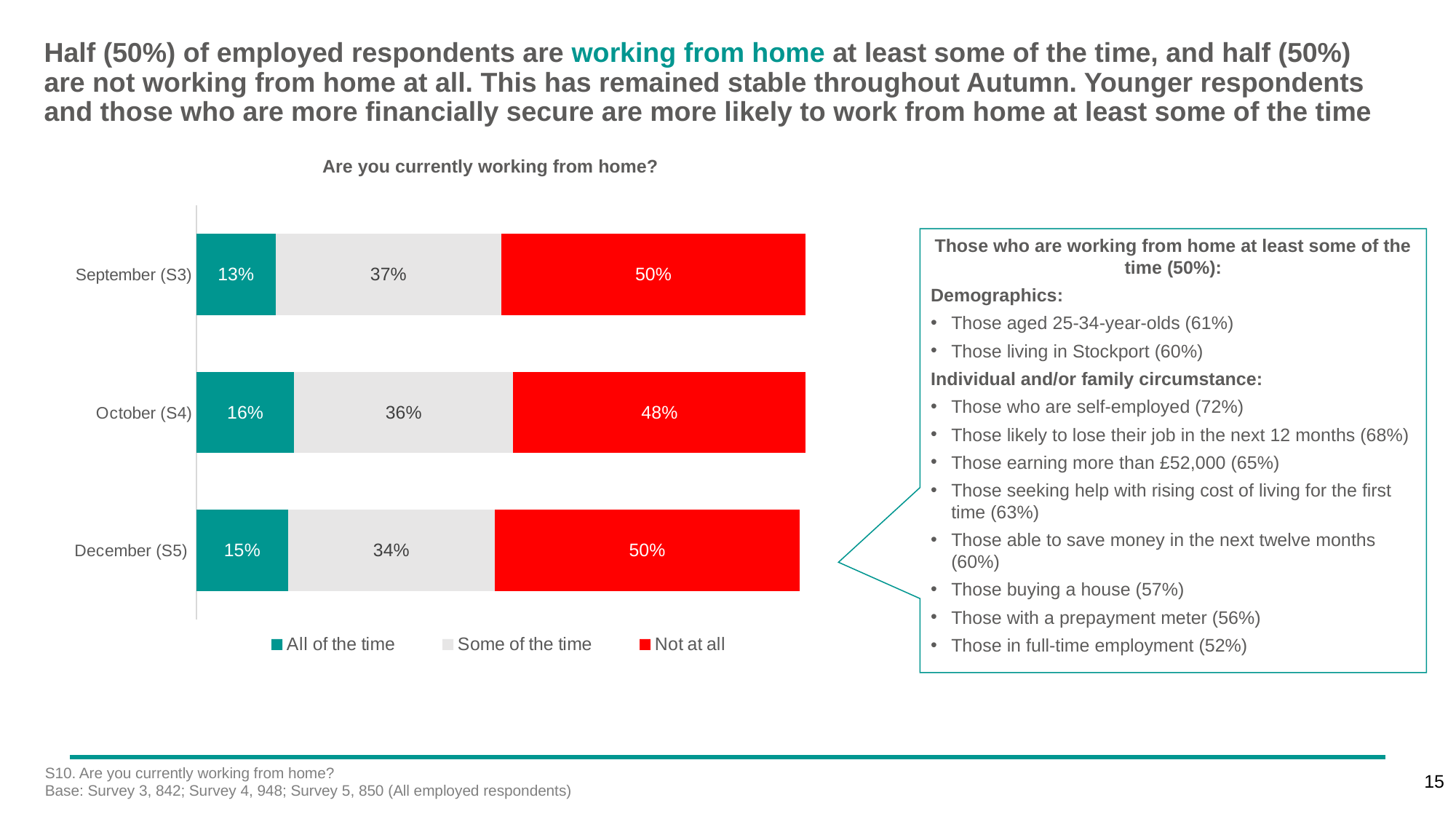
What percentage of respondents in October (S4) were not working from home at all? 48% How many series does the legend list? 3 What is the difference in percentage points between the 'Not at all' share in September (S3) and October (S4)? 2 How many survey waves (categories) are shown in the chart? 3 What percentage of respondents in December (S5) were working from home some of the time? 34% What percentage of respondents in September (S3) were working from home all of the time? 13% What is the combined percentage of respondents working from home all of the time or some of the time in October (S4)? 52% Which survey wave has the lowest share of respondents working from home some of the time? December (S5) Is the 'Some of the time' share larger in September (S3) or December (S5)? September (S3) Which survey wave has the highest share of respondents working from home all of the time? October (S4) What is the title of the chart? Are you currently working from home? What kind of chart is used to show the working from home responses? Stacked bar chart